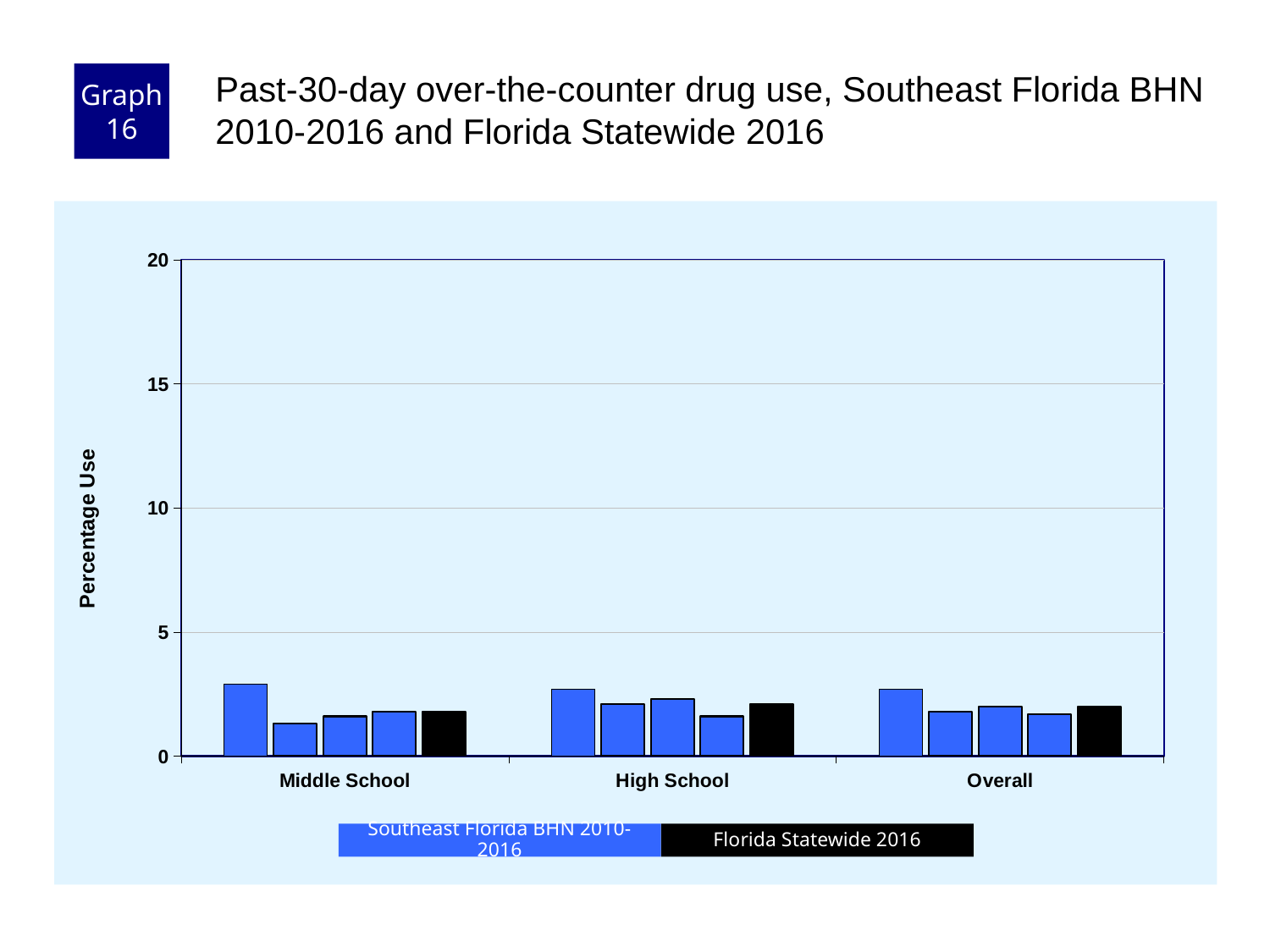
How many series does the chart legend list? 2 What is the label on the y axis of the chart? Percentage Use How many categories are shown on the x axis of the chart? 3 Is the value for Florida Statewide 2016 for Overall greater or less than 10? less What colour are the bars for the Florida Statewide 2016 series? black Is the value for Florida Statewide 2016 for High School greater or less than 5? less Is the value for Florida Statewide 2016 for Middle School greater or less than 5? less What is the highest value shown on the y axis of the chart? 20 What kind of chart is shown on the slide? bar chart